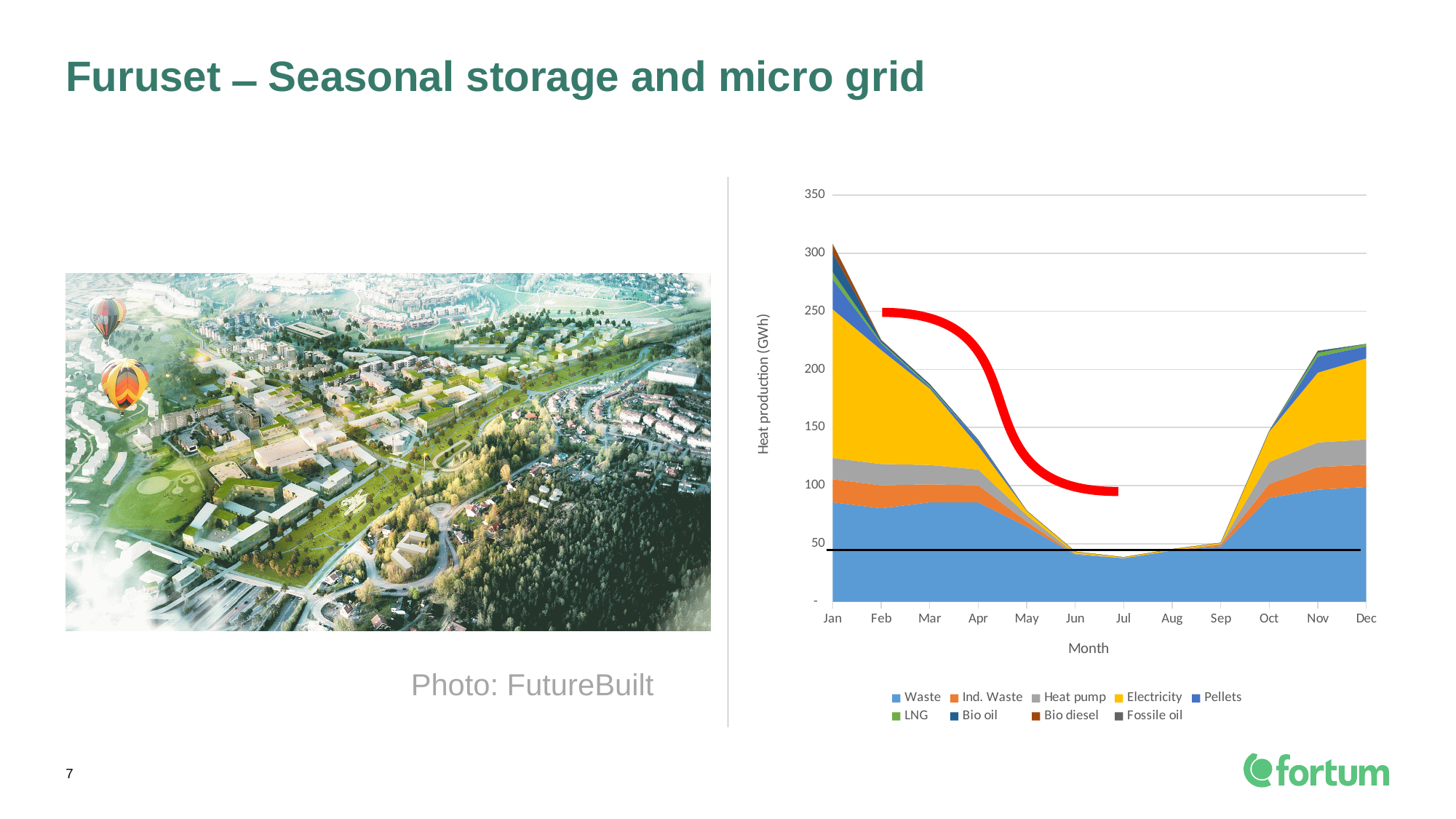
Is the total heat production in Jul greater or less than 50? less How many series does the chart's legend list? 9 Which month has the lowest total heat production in the chart? Jul Does total heat production rise or fall from Jan to Jun? fall Is the total heat production in Jan greater or less than 250? greater What is the label of the y axis of the chart? Heat production (GWh) What kind of chart is shown on the slide? Stacked area chart Which month has the highest total heat production in the chart? Jan Is the total heat production in Dec greater or less than 200? greater How many months are shown along the x axis of the chart? 12 Which month has the larger total heat production, Jan or Dec? Jan Does total heat production rise or fall from Sep to Nov? rise